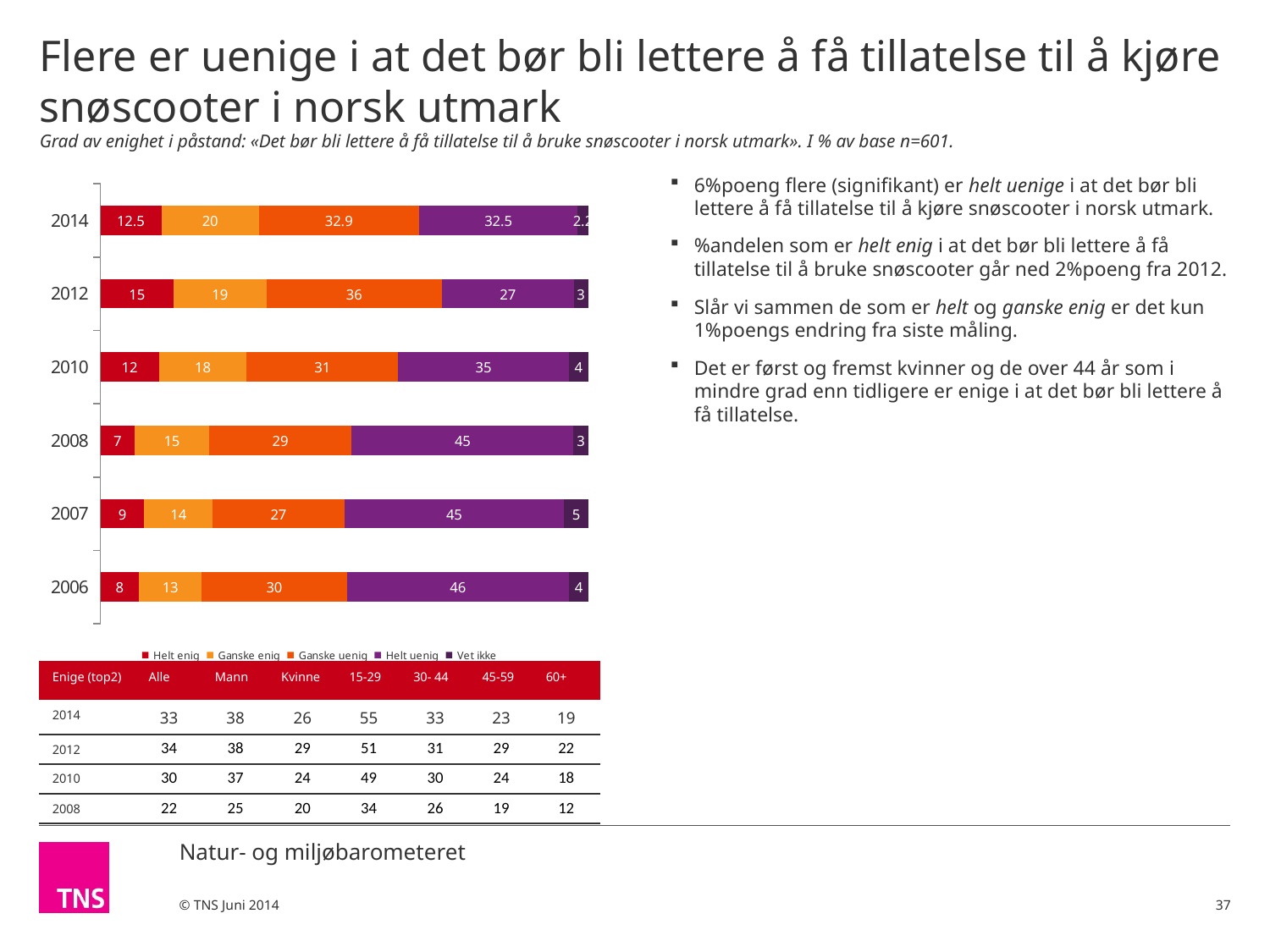
What type of chart is shown on the slide? Stacked bar chart How many years (categories) are shown in the chart? 6 How many series does the chart legend list? 5 In which year is the 'Helt uenig' value highest? 2006 What is the value for 'Helt enig' in 2008? 7 Does the 'Ganske enig' value rise or fall from 2006 to 2014? Rise What is the value for 'Helt uenig' in 2014? 32.5 What is the difference between the 'Helt uenig' values for 2008 and 2012? 18 In which year is the 'Helt enig' value lowest? 2008 What is the value for 'Ganske uenig' in 2012? 36 What is the total of the stacked bar for 2012? 100 Which is larger, the 'Ganske uenig' value in 2010 or in 2012? 2012